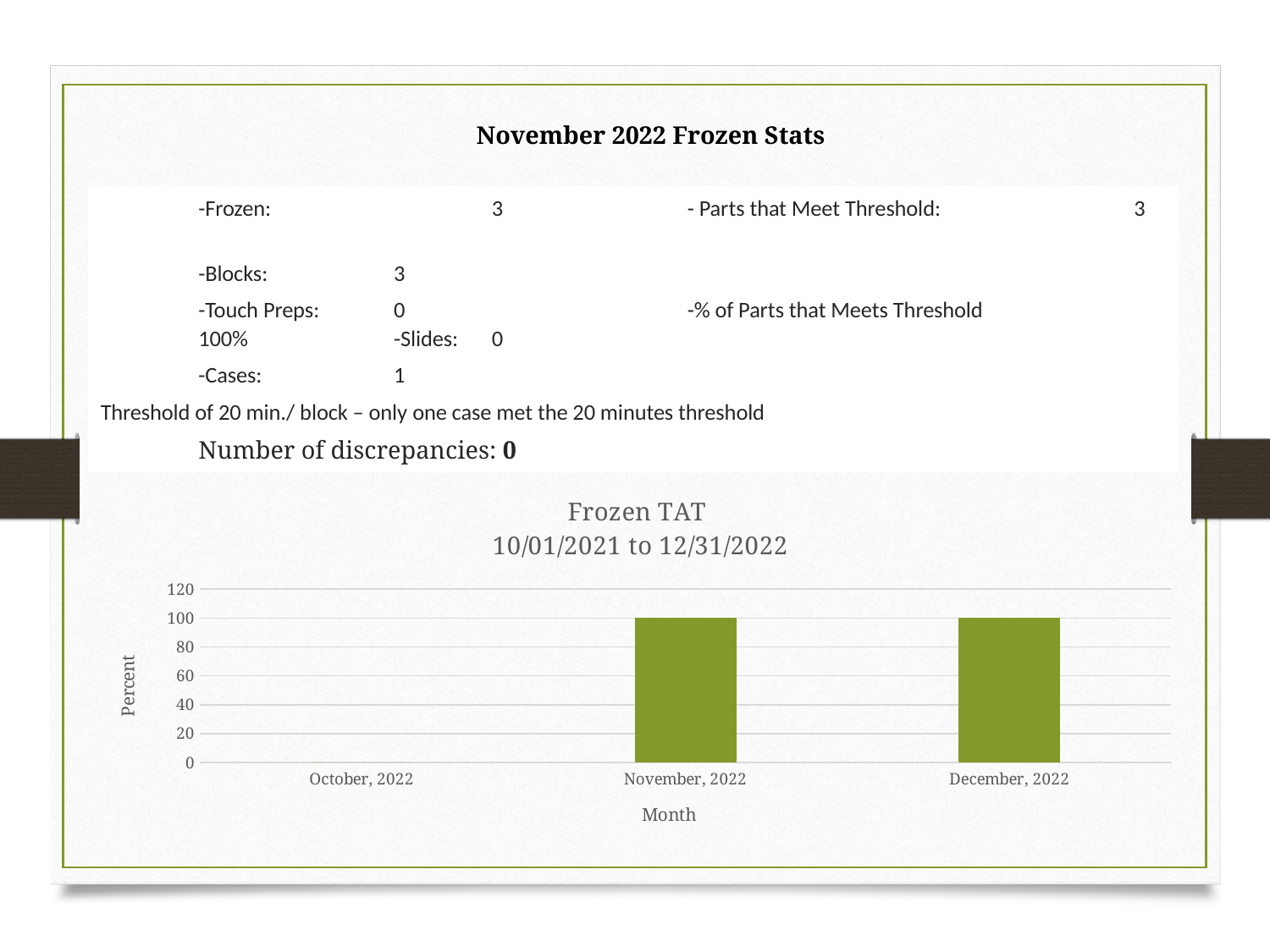
What kind of chart is shown on the slide? bar chart How many months are shown on the x axis of the Frozen TAT chart? 3 Is the value for December, 2022 greater or less than 60? greater What is the value for November, 2022 in the Frozen TAT chart? 100 What is the label on the vertical axis of the chart? Percent Which month has the lowest value in the Frozen TAT chart? October, 2022 What is the title of the chart? Frozen TAT 10/01/2021 to 12/31/2022 Is the value for November, 2022 greater or less than 80? greater What is the value for December, 2022 in the Frozen TAT chart? 100 What is the difference between the values for November, 2022 and December, 2022? 0